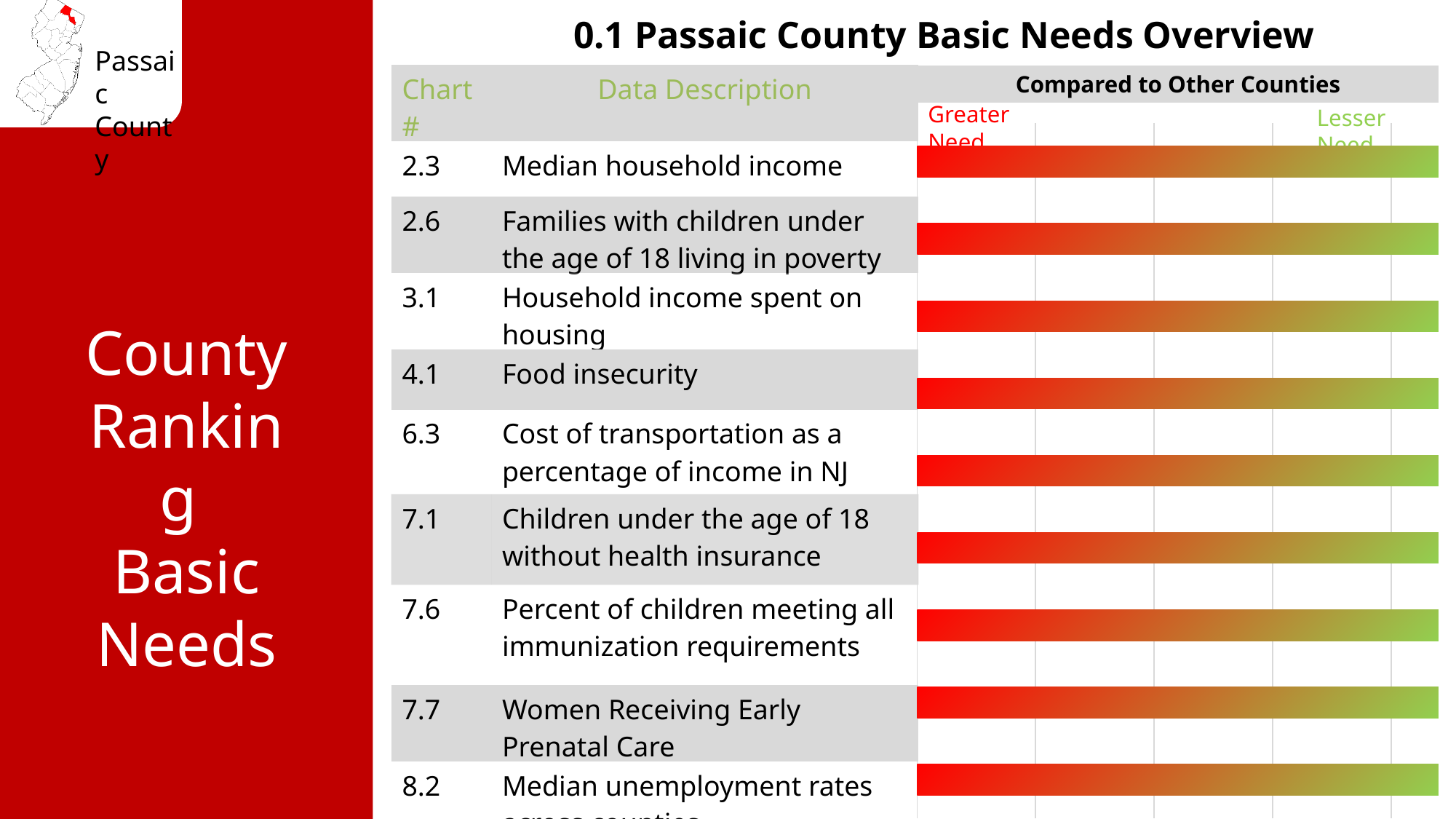
What kind of chart is used to compare Passaic County to other counties? bar chart How many data description rows (categories) are shown in the chart? 9 What label appears at the left (red) end of the comparison bars? Greater Need Which data description corresponds to chart number 7.7? Women Receiving Early Prenatal Care What is the title of the chart on the slide? 0.1 Passaic County Basic Needs Overview What is the chart number for the row labeled "Median household income"? 2.3 What is the chart number for the row labeled "Food insecurity"? 4.1